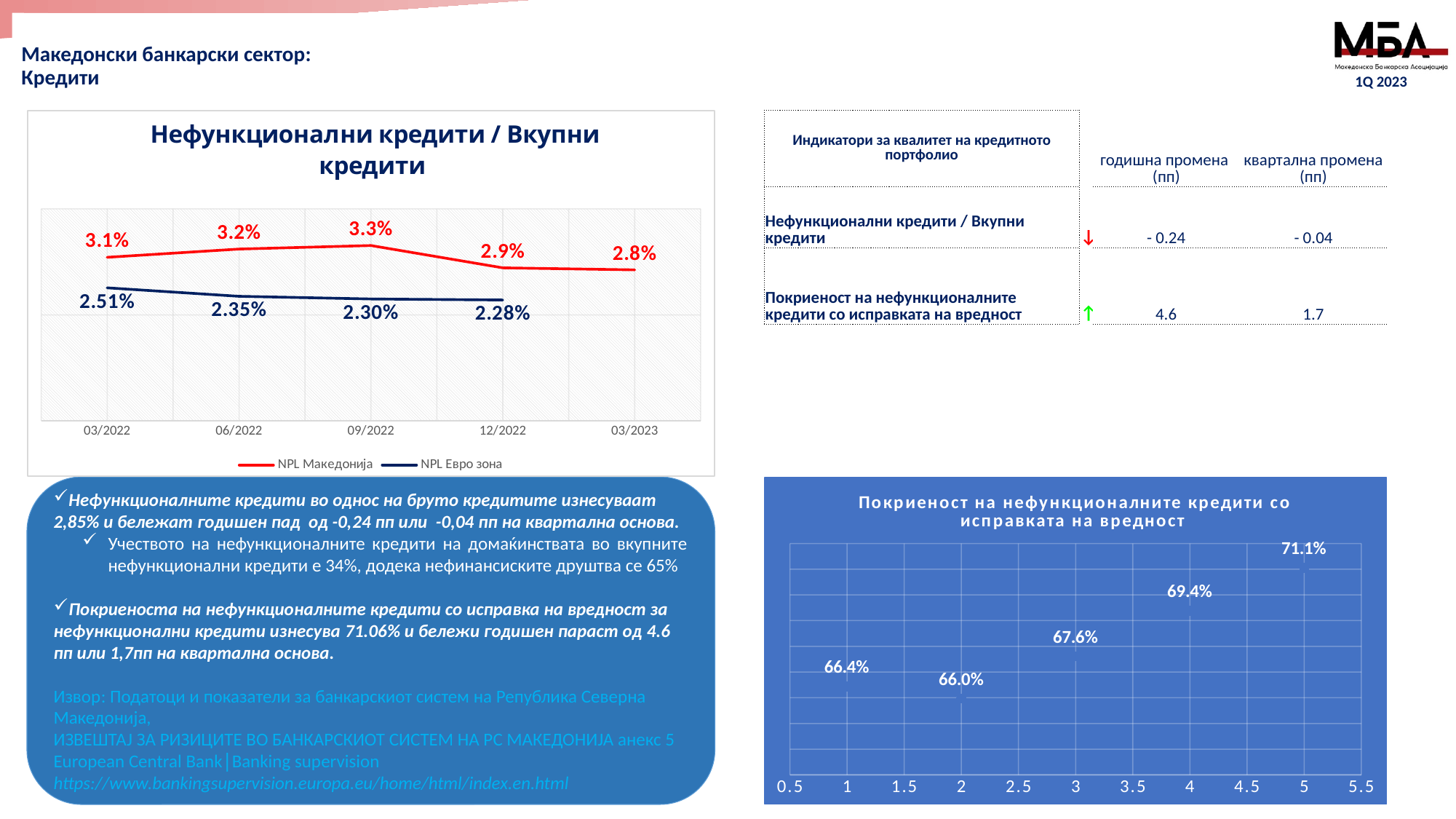
In the chart titled 'Покриеност на нефункционалните кредити со исправката на вредност', what is the lowest labelled value? 66.0% In the chart titled 'Нефункционални кредити / Вкупни кредити', which series is higher at 06/2022, NPL Македонија or NPL Евро зона? NPL Македонија What kind of chart is the one titled 'Нефункционални кредити / Вкупни кредити'? Line chart In the chart titled 'Нефункционални кредити / Вкупни кредити', what is the difference between NPL Македонија and NPL Евро зона at 12/2022? 0.62 percentage points In the chart titled 'Нефункционални кредити / Вкупни кредити', how many dates are shown on the x axis? 5 In the chart titled 'Нефункционални кредити / Вкупни кредити', how many series does the legend list? 2 In the chart titled 'Нефункционални кредити / Вкупни кредити', what is the value of NPL Македонија for 03/2023? 2.8% In the chart titled 'Нефункционални кредити / Вкупни кредити', at which date is NPL Македонија highest? 09/2022 In the chart titled 'Нефункционални кредити / Вкупни кредити', what is the value of NPL Македонија for 09/2022? 3.3% In the chart titled 'Покриеност на нефункционалните кредити со исправката на вредност', what is the highest labelled value? 71.1% In the chart titled 'Нефункционални кредити / Вкупни кредити', at which date is NPL Евро зона lowest? 12/2022 In the chart titled 'Нефункционални кредити / Вкупни кредити', what is the value of NPL Евро зона for 03/2022? 2.51%